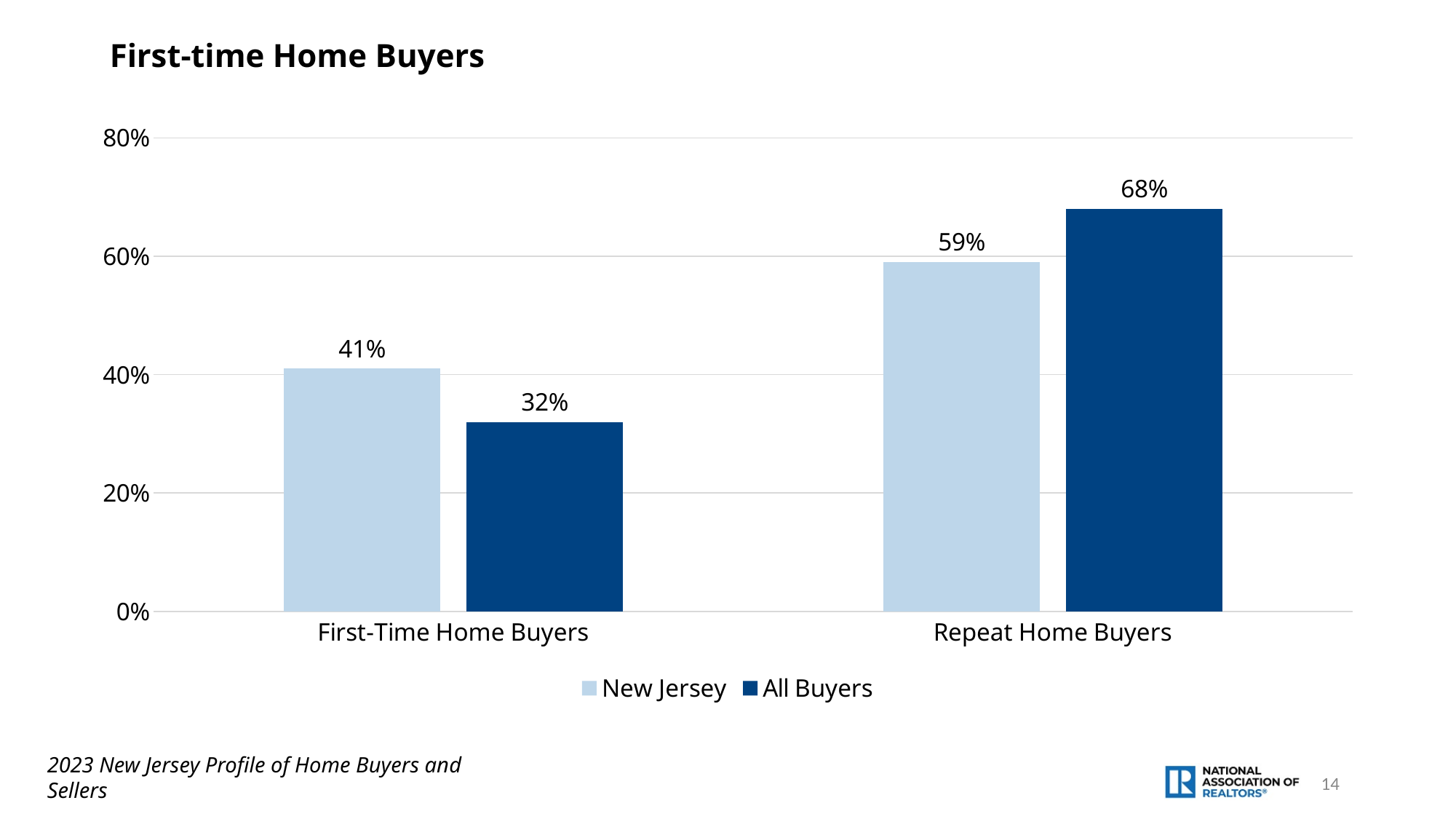
What is the value for New Jersey in the Repeat Home Buyers category? 59% What kind of chart is shown on the slide? Bar chart Which bar has the highest value on the chart? All Buyers, Repeat Home Buyers What is the value for All Buyers in the Repeat Home Buyers category? 68% How many series does the legend list? 2 Which is larger for Repeat Home Buyers: New Jersey or All Buyers? All Buyers What is the value for All Buyers in the First-Time Home Buyers category? 32% What is the difference between the All Buyers and New Jersey values for Repeat Home Buyers? 9% What is the difference between the New Jersey and All Buyers values for First-Time Home Buyers? 9% Which bar has the lowest value on the chart? All Buyers, First-Time Home Buyers What percentage of New Jersey buyers are First-Time Home Buyers? 41% What is the title of the chart? First-time Home Buyers